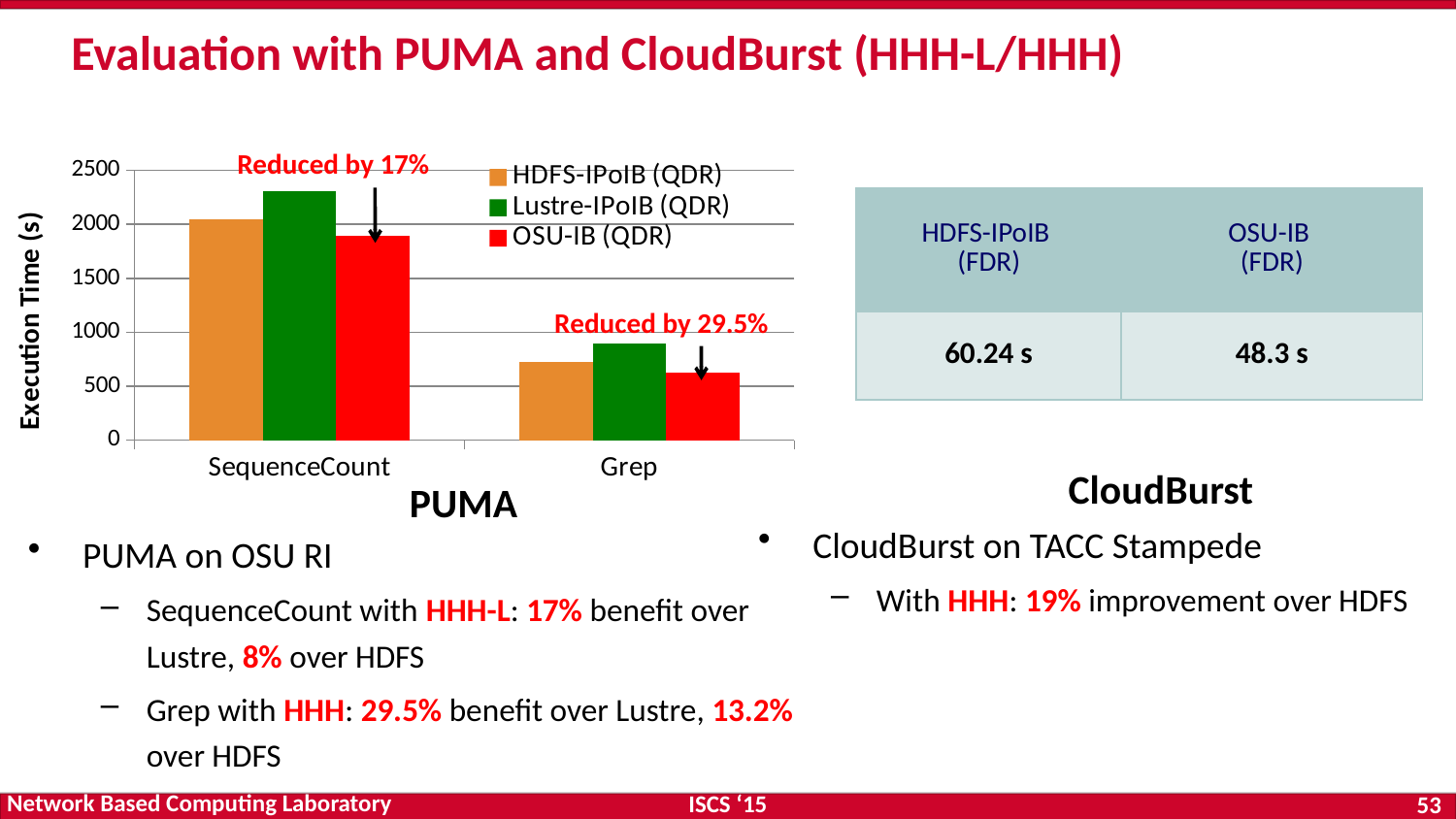
Is the execution time for OSU-IB (QDR) on Grep greater or less than 500? greater For HDFS-IPoIB (QDR), which category has the larger execution time, SequenceCount or Grep? SequenceCount Which series has the highest execution time for SequenceCount? Lustre-IPoIB (QDR) Is the execution time for Lustre-IPoIB (QDR) on SequenceCount greater or less than 2000? greater Is the execution time for OSU-IB (QDR) on SequenceCount greater or less than 2000? less Which series has the lowest execution time for Grep? OSU-IB (QDR) How many series does the legend of the PUMA chart list? 3 What kind of chart is shown on the slide? bar chart What is the label of the y axis of the PUMA chart? Execution Time (s) What reduction percentage is annotated above the SequenceCount bars? Reduced by 17% How many categories are shown on the x axis of the PUMA chart? 2